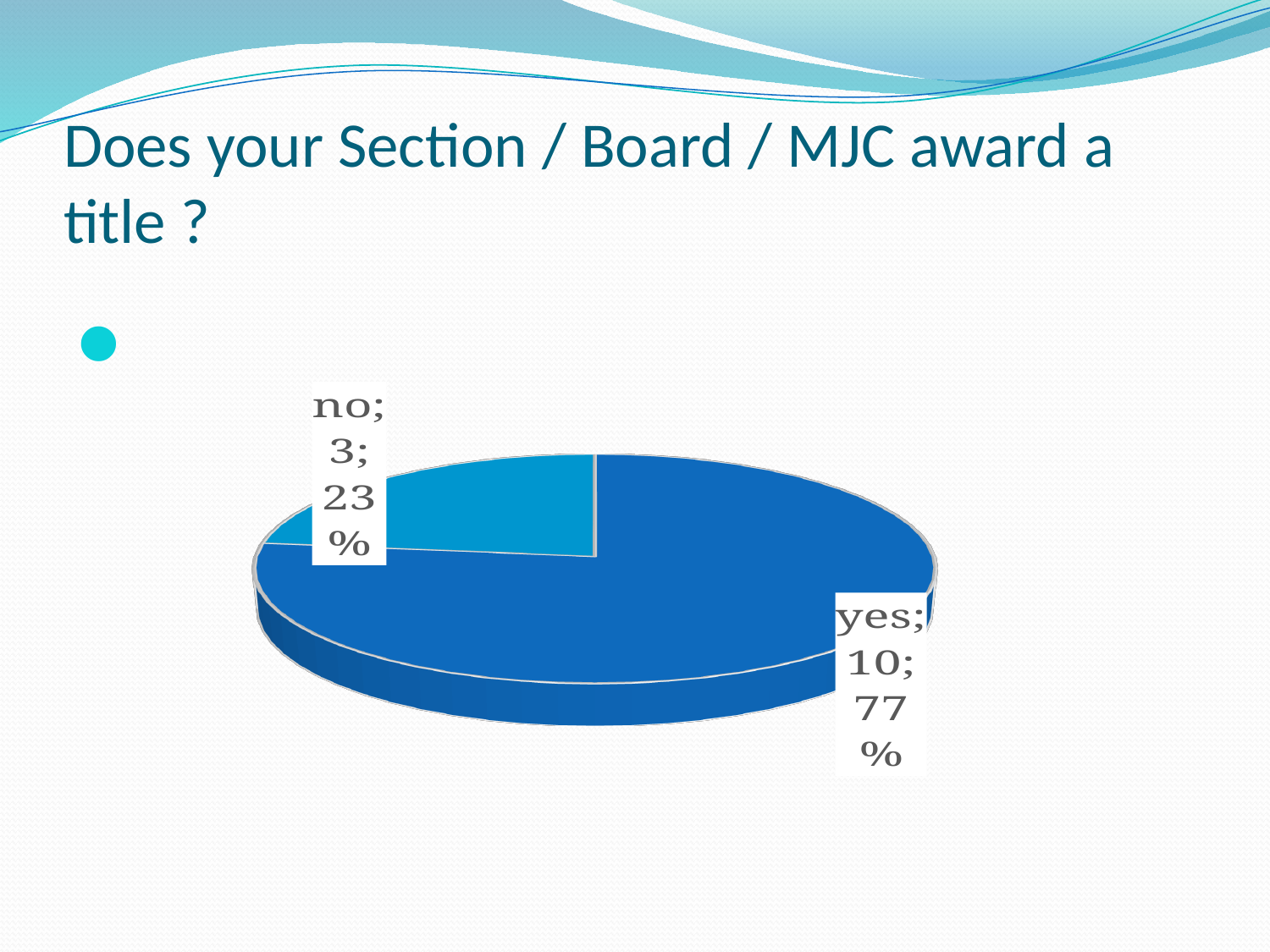
How many slices does the pie chart have? 2 What kind of chart is shown on the slide? pie chart What is the difference between the counts for "yes" and "no"? 7 What is the total count across both slices? 13 What question does the slide title ask? Does your Section / Board / MJC award a title ? Which is larger, the "yes" slice or the "no" slice? yes Which slice is the smallest? no What is the count for the "yes" slice? 10 Which slice is the largest? yes What percentage share does the "no" slice have? 23% What is the count for the "no" slice? 3 What percentage share does the "yes" slice have? 77%